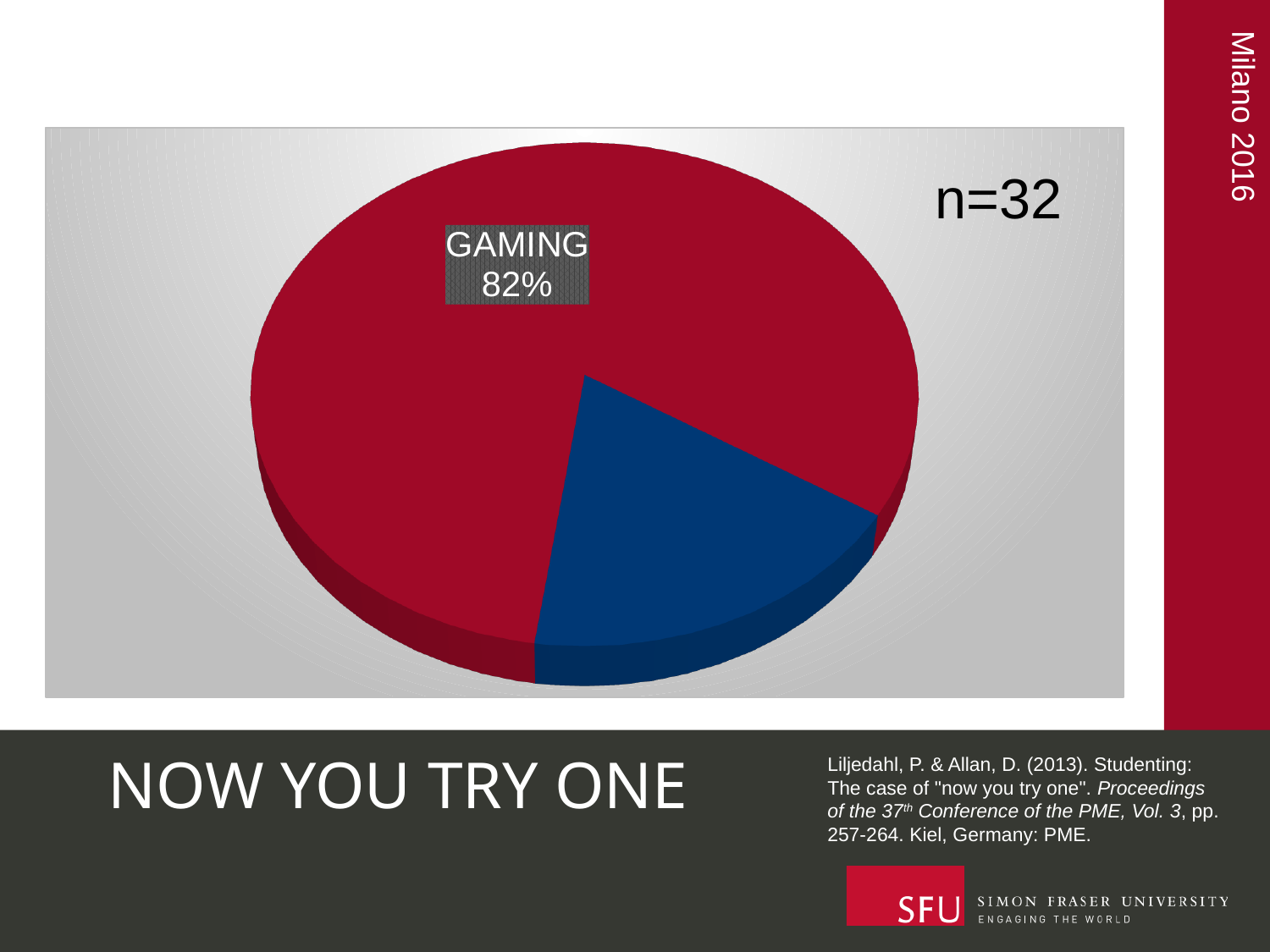
How many slices does the pie chart have? 2 What colour is the GAMING slice of the pie chart? red What kind of chart is shown on the slide? pie chart Is the GAMING slice greater or less than half of the pie? greater What sample size (n) is shown next to the pie chart? n=32 What percentage is shown for the GAMING slice of the pie chart? 82% Is the blue slice of the pie chart greater or less than half of the pie? less Which slice of the pie chart is the largest? GAMING What share of the pie does the GAMING slice represent? 82% Which is larger in the pie chart, the red GAMING slice or the blue slice? the red GAMING slice